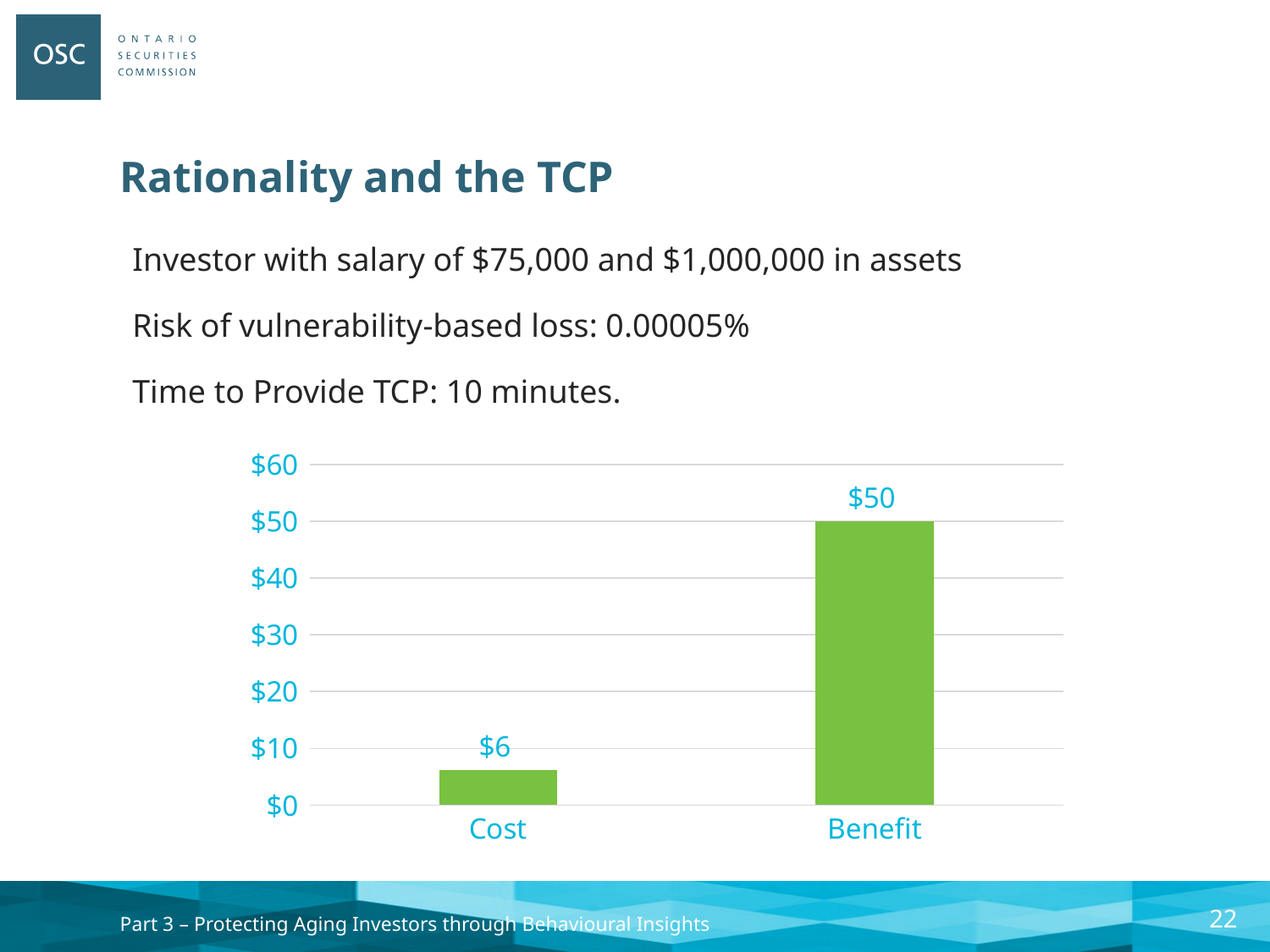
What is the value for Cost? $6 How many categories are shown in the chart? 2 Is the value for Benefit greater or less than $40? greater What is the highest value shown on the vertical axis? $60 What kind of chart is shown on the slide? bar chart Is the value for Cost greater or less than $10? less What colour are the bars in the chart? green Which category has the lowest value? Cost What is the value for Benefit? $50 Which is larger, Cost or Benefit? Benefit Which category has the highest value? Benefit What is the difference between the Benefit and Cost values? $44